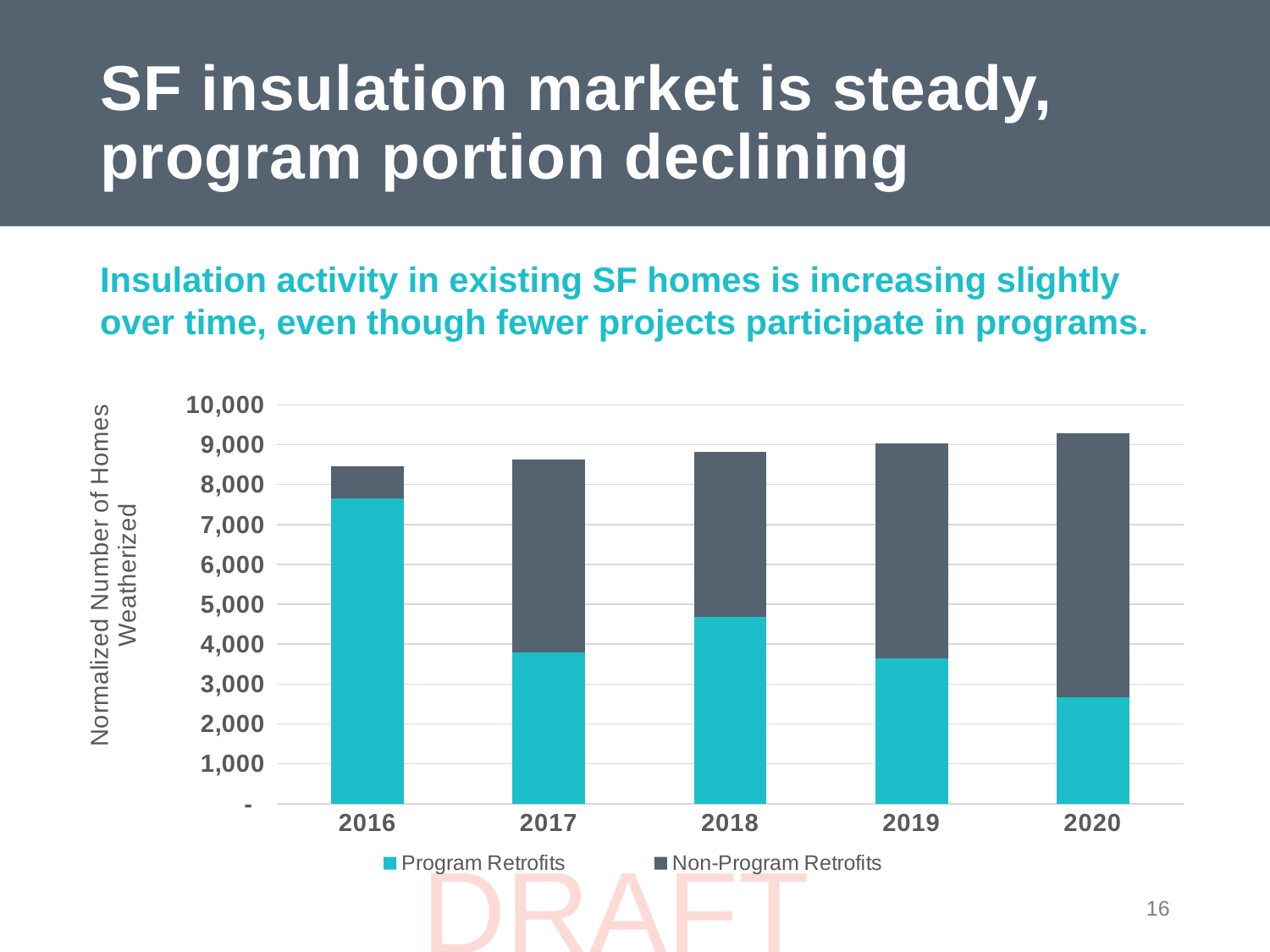
Do the total heights of the stacked bars rise or fall from 2016 to 2020? rise Which year has a larger value for Program Retrofits, 2017 or 2018? 2018 Which year has the lowest value for Program Retrofits? 2020 What kind of chart is shown on the slide? Stacked bar chart How many series does the chart's legend list? 2 How many years are shown on the x axis of the chart? 5 Is the value for Program Retrofits in 2020 greater or less than 3,000? less Is the value for Program Retrofits in 2016 greater or less than 7,000? greater Which year has the highest value for Program Retrofits? 2016 Which year has a taller total stacked bar, 2016 or 2020? 2020 What is the label on the y axis of the chart? Normalized Number of Homes Weatherized Is the total height of the 2016 stacked bar greater or less than 9,000? less